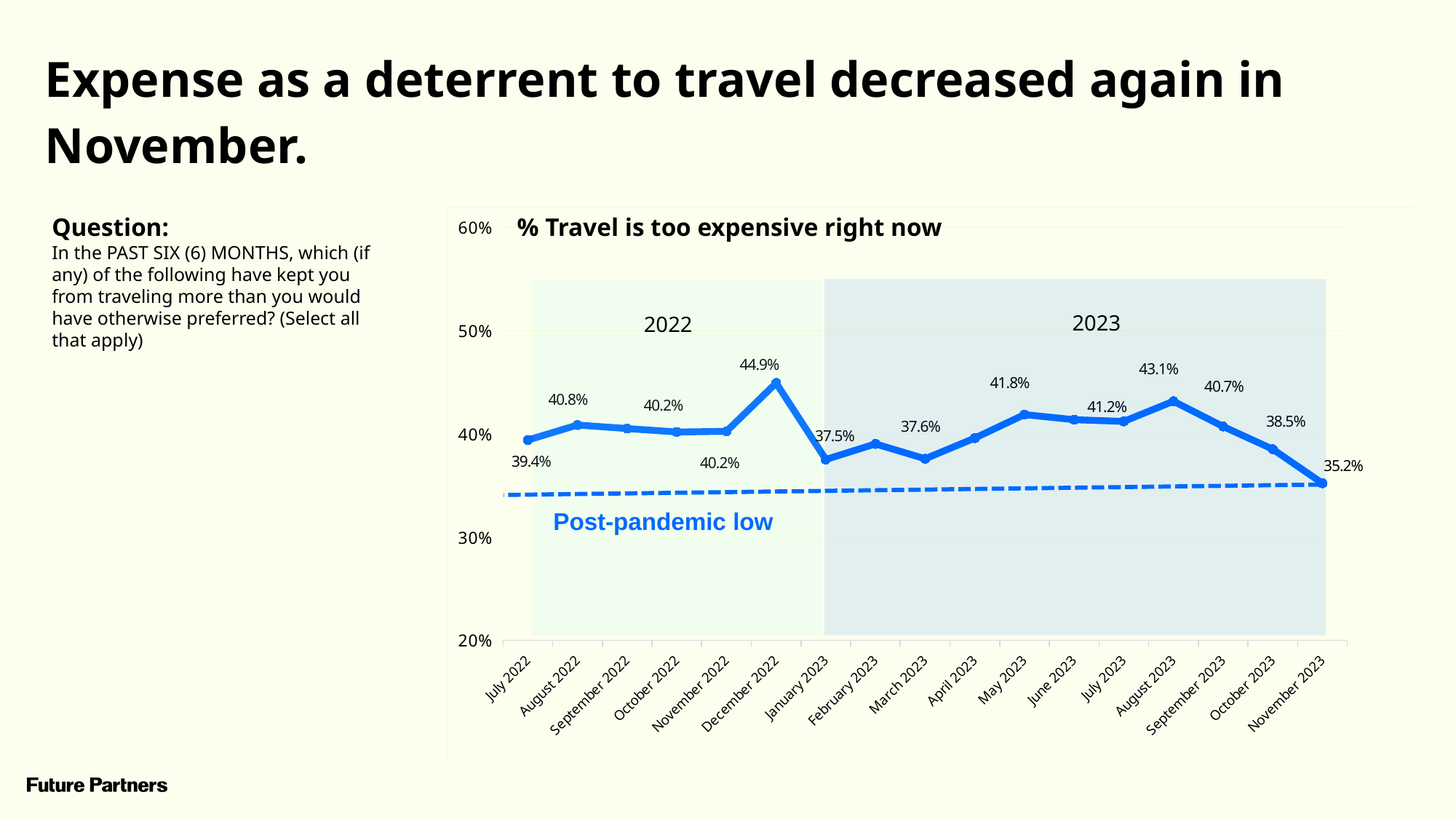
How many months are plotted on the x axis? 17 What is the value for December 2022? 44.9% Is the value for March 2023 greater or less than 40%? less What is the value for August 2023? 43.1% What is the difference between the values for October 2023 and November 2023? 3.3 percentage points What type of chart is shown on the slide? line chart Which month has the highest value? December 2022 What is the value for July 2022? 39.4% What is the value for November 2023? 35.2% What is the title of the chart? % Travel is too expensive right now Which month has the lowest value? November 2023 Which is larger, the value for January 2023 or the value for August 2022? August 2022